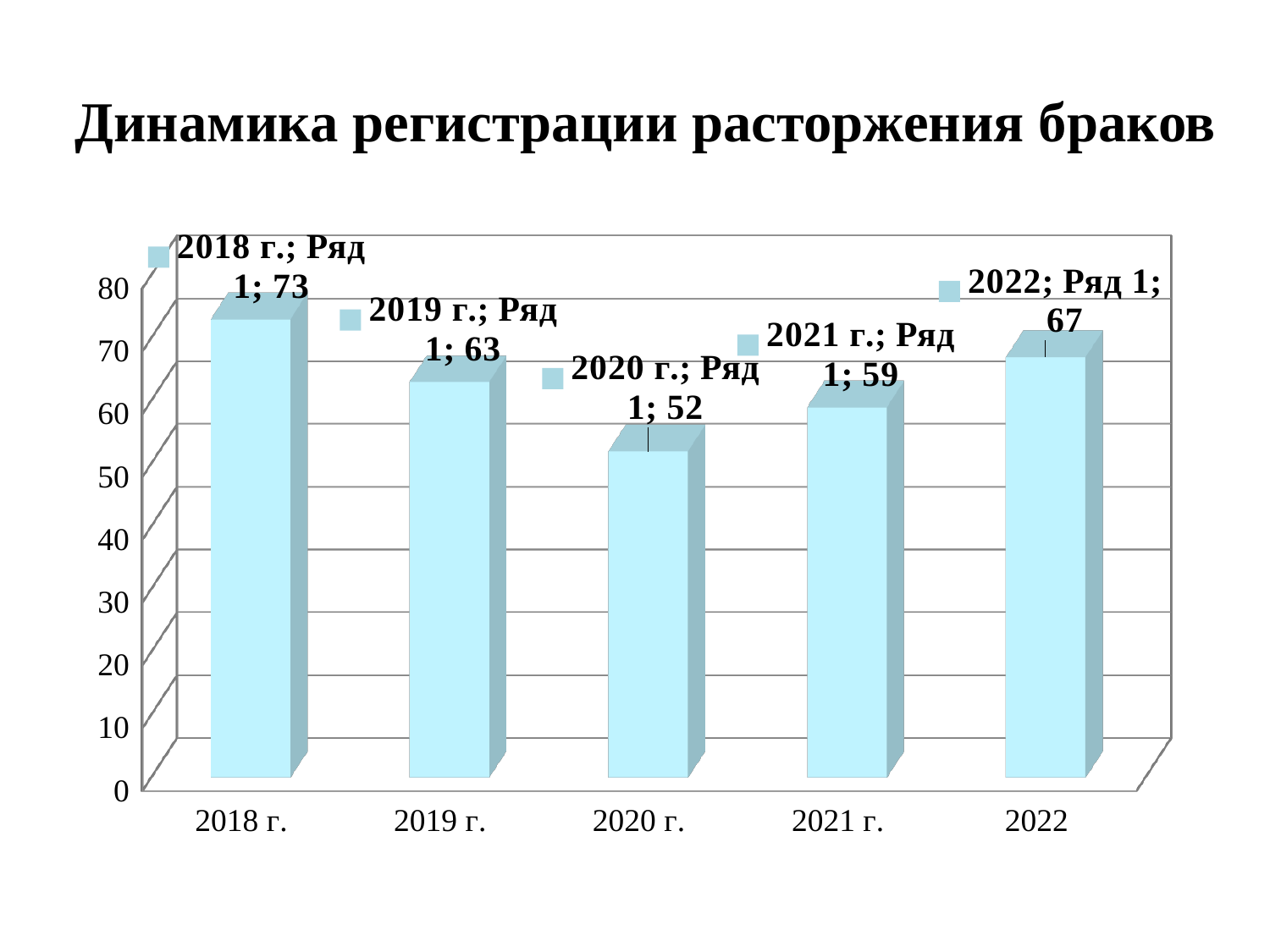
What is the difference between the values for 2022 and 2021 г.? 8 What is the value for 2018 г.? 73 Is the value for 2021 г. greater or less than 50? greater Which is larger, the value for 2019 г. or the value for 2021 г.? 2019 г. What kind of chart is this? bar chart What is the value for 2022? 67 Which year has the lowest value? 2020 г. What is the title of the chart? Динамика регистрации расторжения браков How many years are shown on the x axis? 5 What is the difference between the values for 2018 г. and 2020 г.? 21 What is the value for 2020 г.? 52 Which year has the highest value? 2018 г.